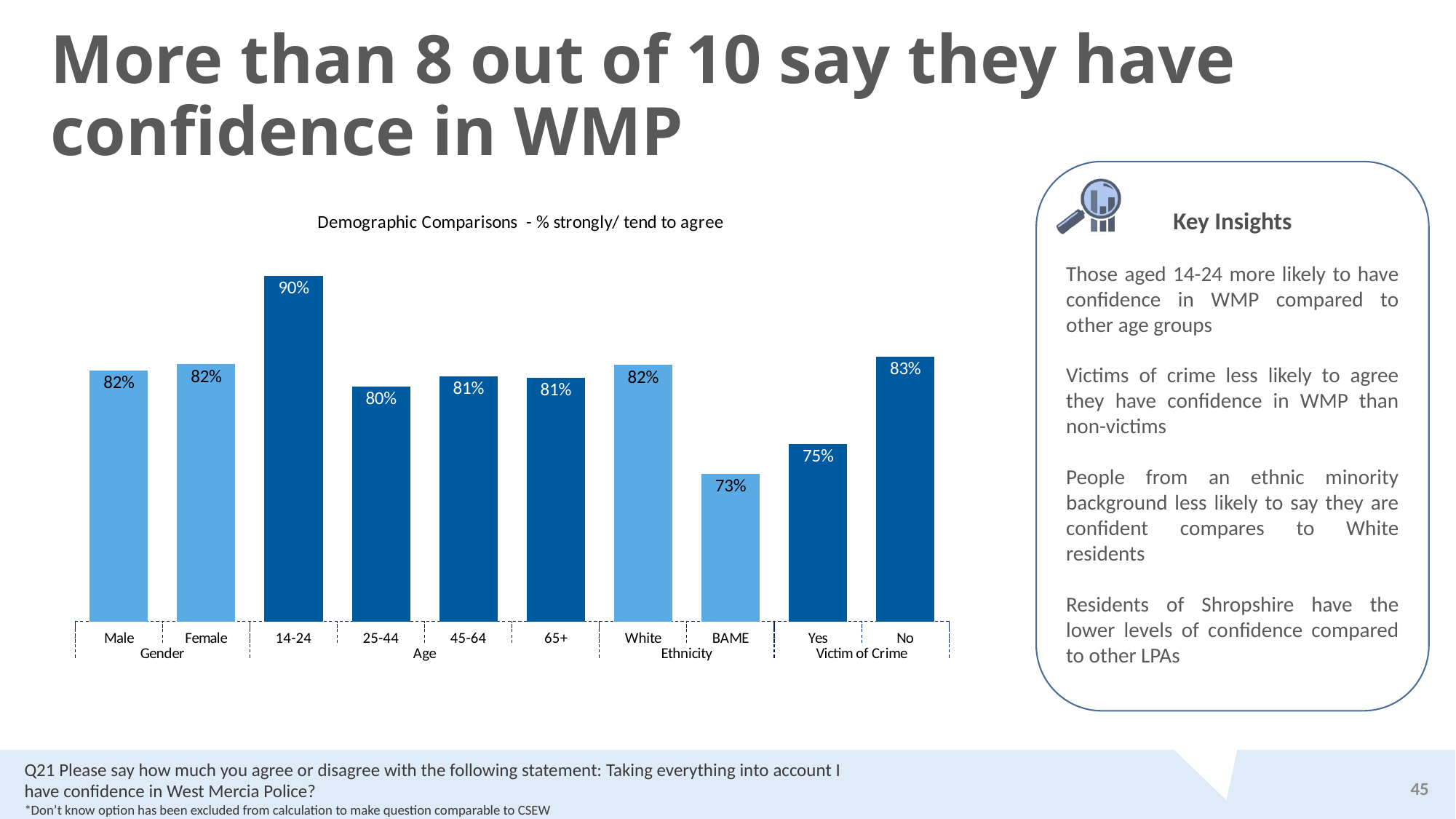
What is the value for Female respondents? 82% What is the difference between the White and BAME values? 9 percentage points Which category has the highest value? 14-24 How many categories (bars) are shown in the chart? 10 What is the difference between the No and Yes values under Victim of Crime? 8 percentage points What type of chart is shown on the slide? Bar chart What is the value for the 14-24 age group? 90% Which is larger, the value for 25-44 or the value for 14-24? 14-24 Which category has the lowest value? BAME What is the title of the chart? Demographic Comparisons - % strongly/ tend to agree What is the value for BAME respondents? 73% What is the value for respondents who were a victim of crime (Yes)? 75%